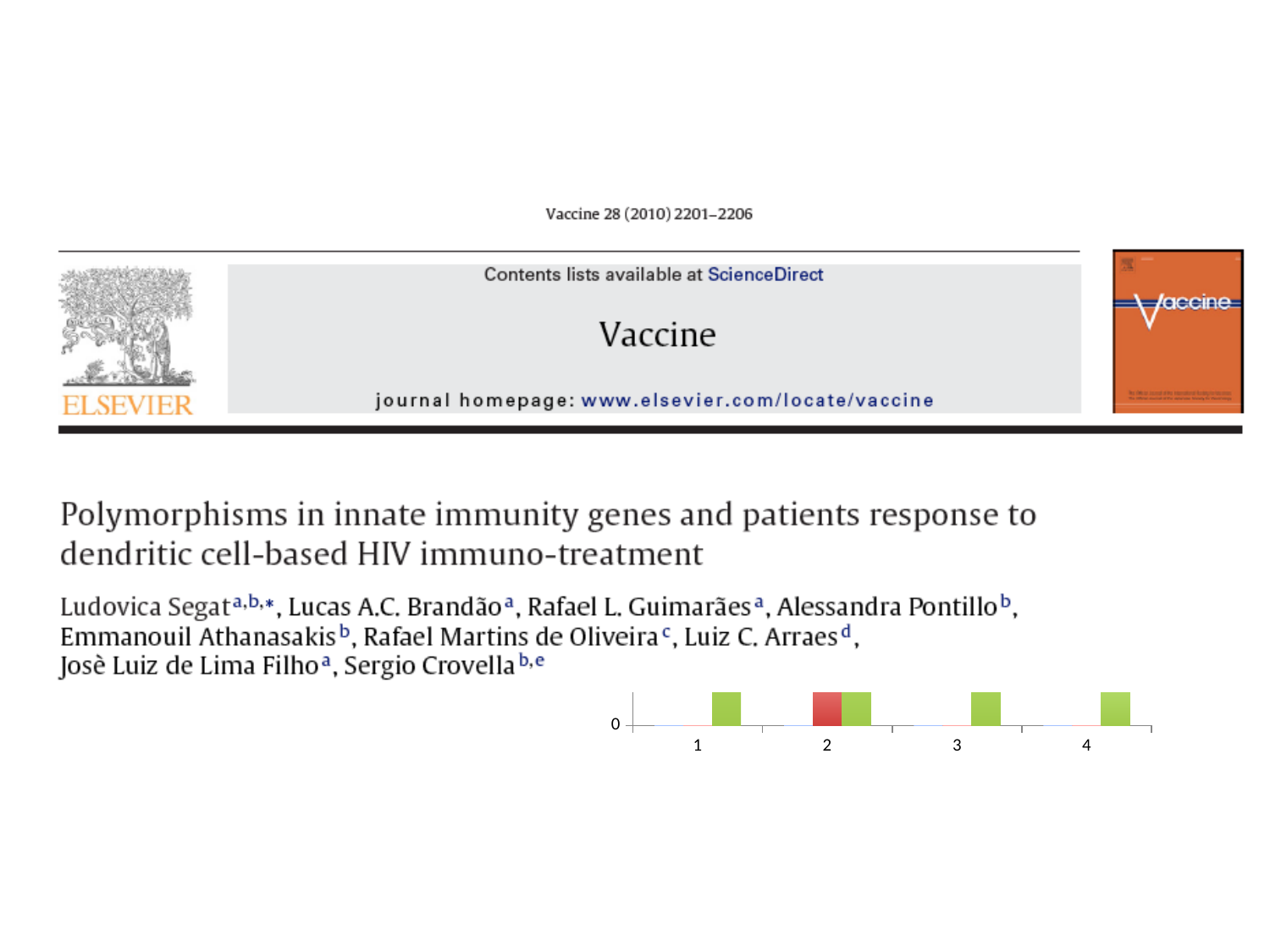
Which category on the x axis has a red bar? 2 Is the value for category 1 greater or less than 0? greater How many categories are labelled on the x axis of the chart? 4 Is the value for category 4 greater or less than 0? greater What is the only value printed on the y axis of the chart? 0 What kind of chart is shown at the bottom of the slide? bar chart What colour are the bars for categories 1, 3 and 4? green